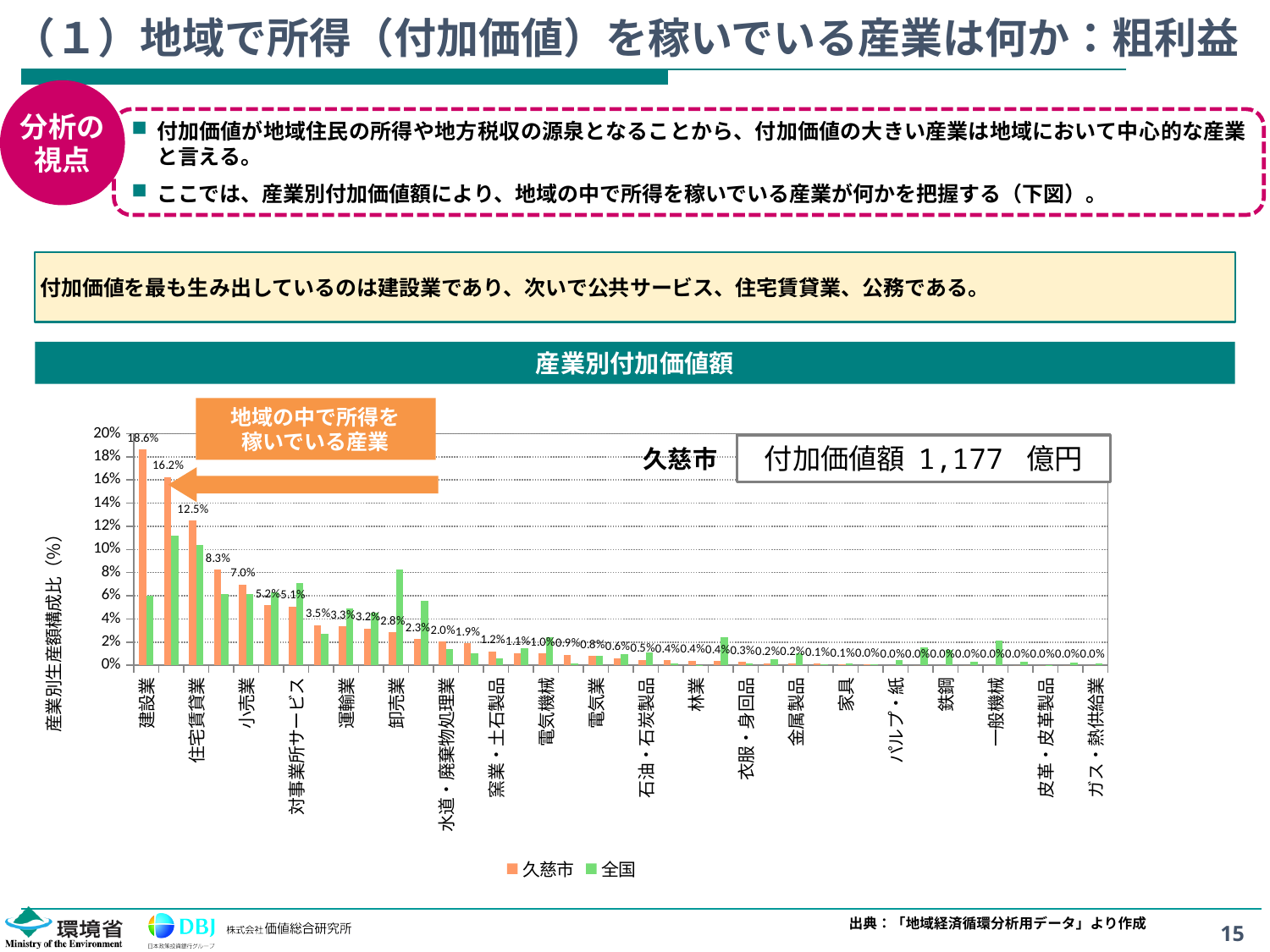
In the 産業別付加価値額 chart, what is the difference between the 久慈市 values for 建設業 and 住宅賃貸業? 6.1% In the 産業別付加価値額 chart, what is the 久慈市 value for 建設業? 18.6% In the 産業別付加価値額 chart, what is the 久慈市 value for 住宅賃貸業? 12.5% In the 産業別付加価値額 chart, what is the 久慈市 value for 対事業所サービス? 5.1% In the 産業別付加価値額 chart, for 建設業, which series has the larger value, 久慈市 or 全国? 久慈市 In the 産業別付加価値額 chart, what is the 久慈市 value for 卸売業? 2.8% In the 産業別付加価値額 chart, what is the 久慈市 value for 小売業? 7.0% In the 産業別付加価値額 chart, which industry has the highest 久慈市 value? 建設業 How many series does the legend of the 産業別付加価値額 chart list? 2 What kind of chart is the 産業別付加価値額 chart? bar chart In the 産業別付加価値額 chart, is the 全国 value for 建設業 greater or less than 8%? less In the 産業別付加価値額 chart, do the 久慈市 values rise or fall from left to right along the x axis? fall